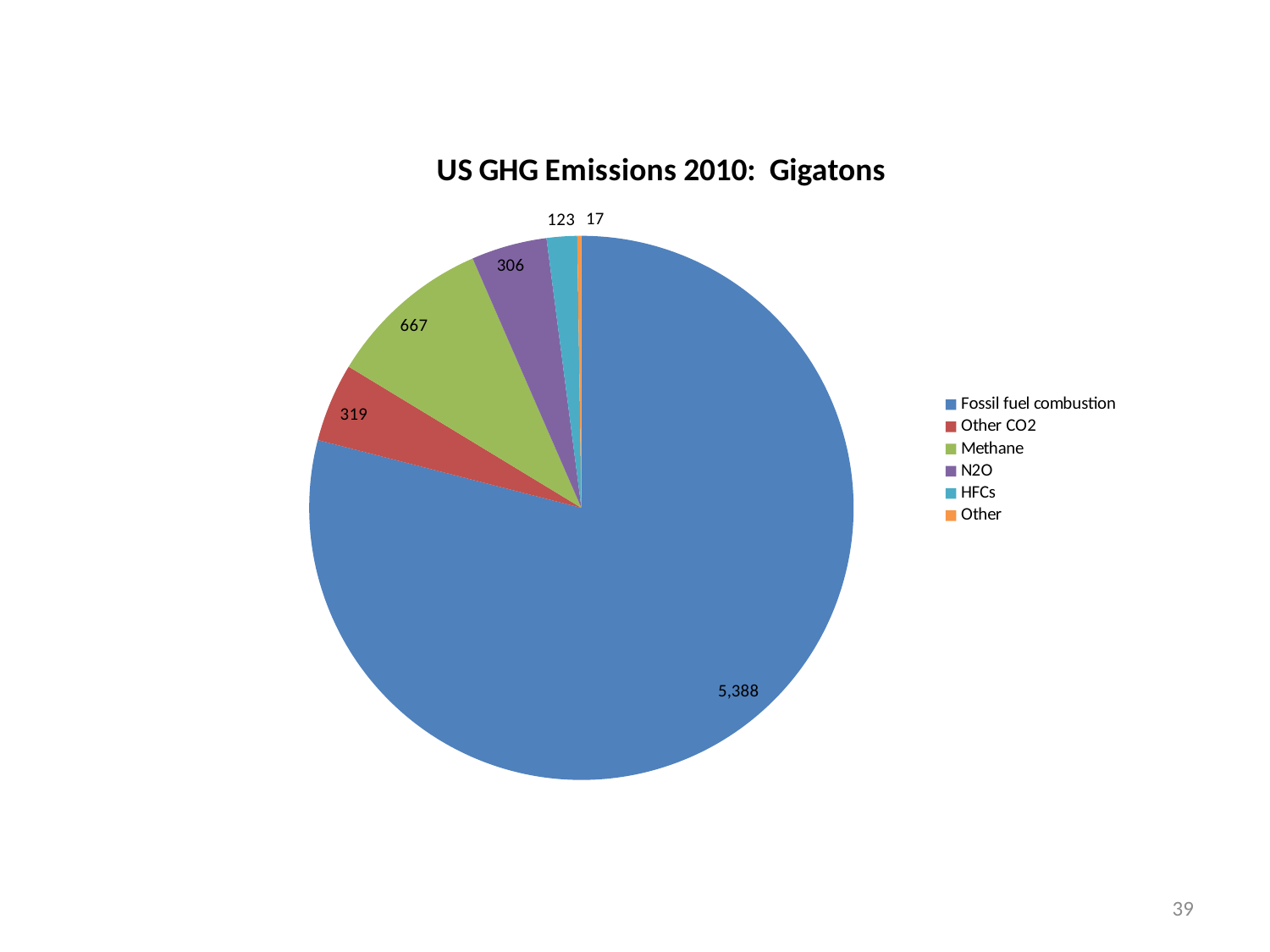
What is the value for HFCs? 123 Which is larger, the value for Other CO2 or the value for N2O? Other CO2 What type of chart is shown on the slide? Pie chart What is the title of the chart? US GHG Emissions 2010: Gigatons What is the value for N2O? 306 What is the total of all the slices in the pie? 6,820 How many categories does the legend list? 6 What is the value for Methane? 667 Which category has the largest slice of the pie? Fossil fuel combustion What is the difference between the Methane value and the Other CO2 value? 348 Which category has the smallest slice of the pie? Other What is the value for Fossil fuel combustion? 5,388